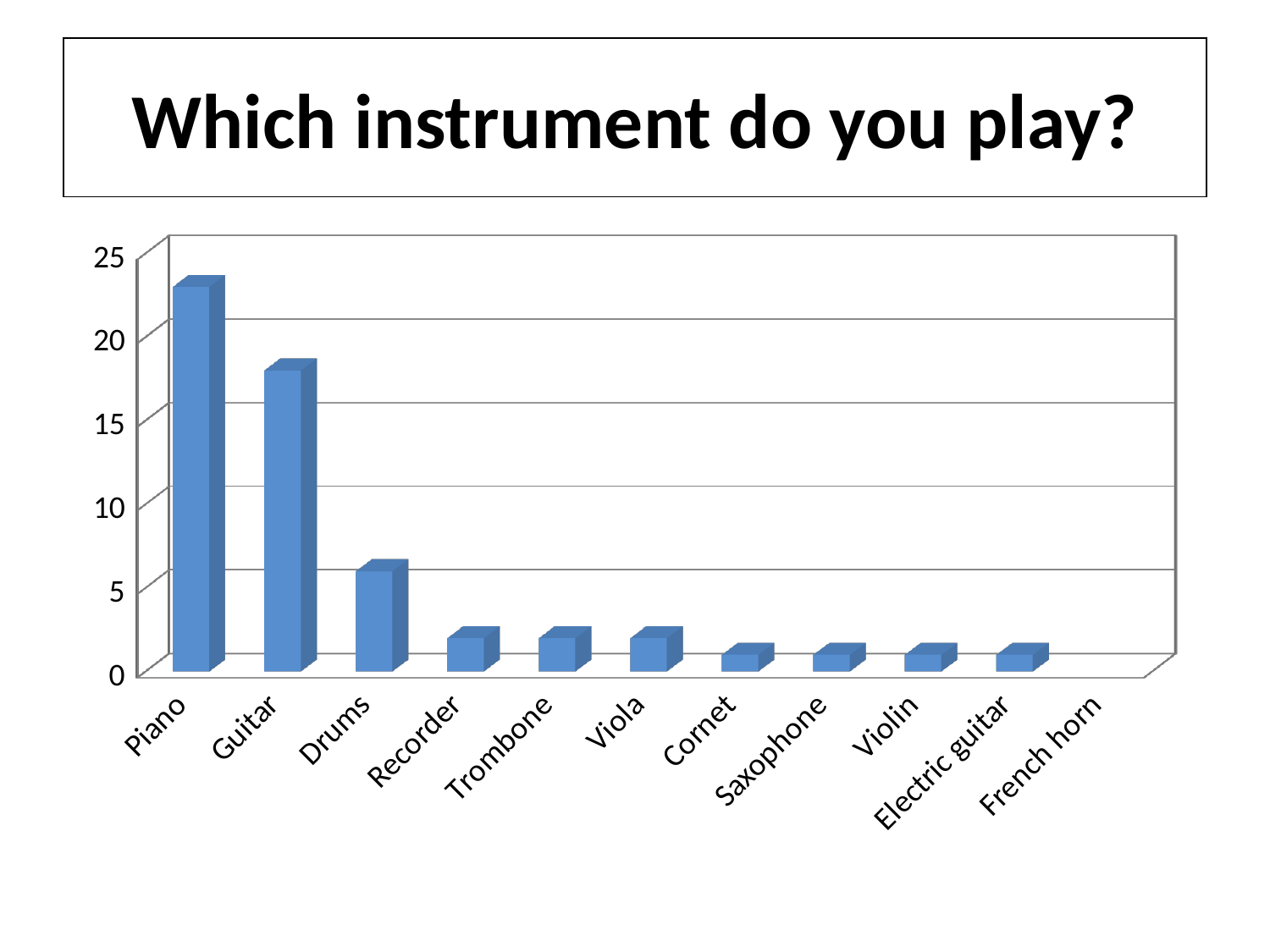
Which has the larger value, Guitar or Drums? Guitar Is the value for Drums greater or less than 10? less Which instrument has the highest value? Piano Do the values generally rise or fall moving from left to right along the x axis? Fall What kind of chart is shown on the slide? Bar chart Is the value for Piano greater or less than 20? greater Is the value for Guitar greater or less than 20? less How many instrument categories are shown on the x axis? 11 What is the title of the chart? Which instrument do you play? Which instrument has the lowest value? French horn